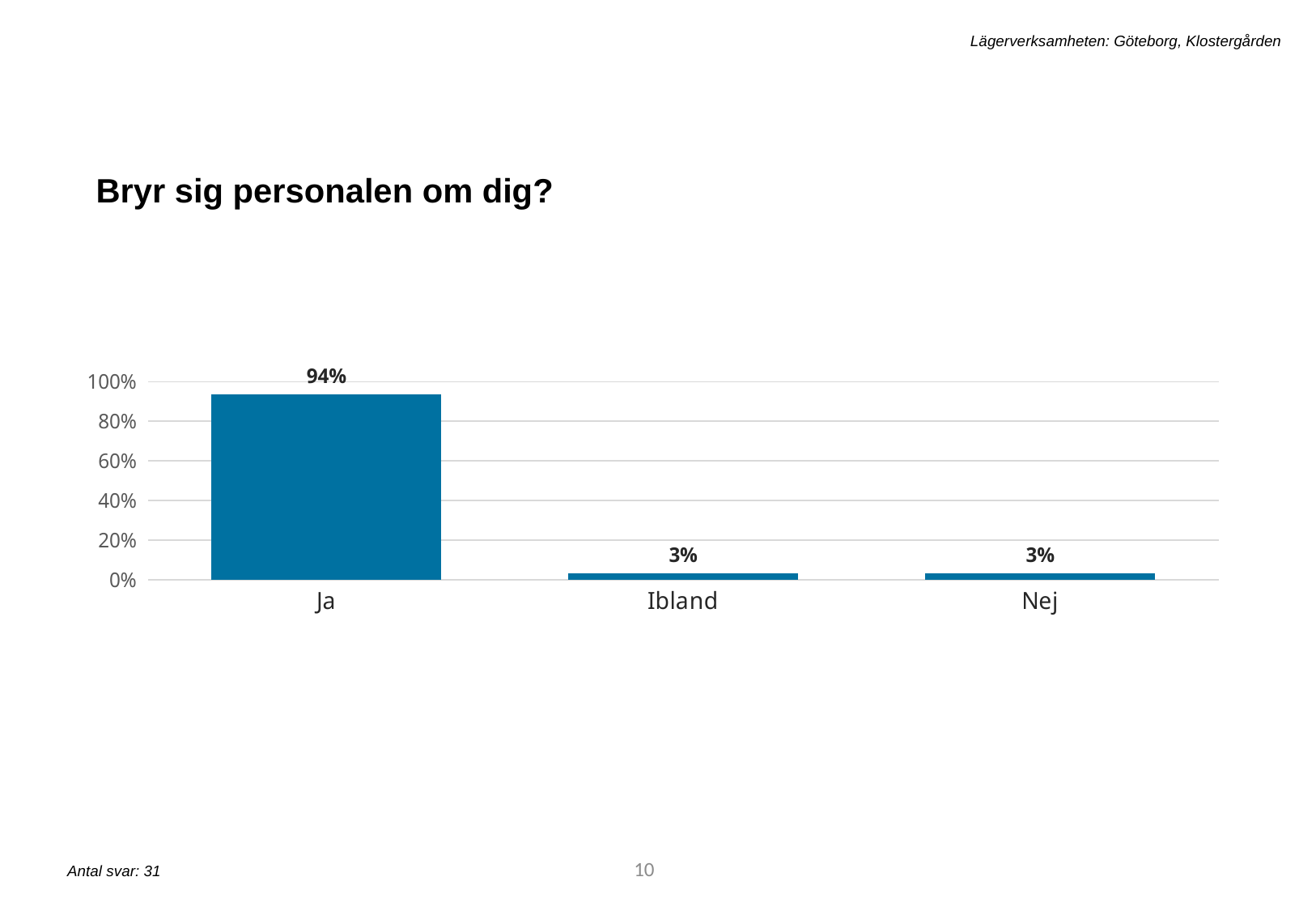
Is the value for Nej greater or less than 20%? less Which category has the highest value? Ja What is the title of the chart? Bryr sig personalen om dig? What is the difference between the values for Ja and Ibland? 91% What kind of chart is shown on the slide? bar chart What is the value for Ibland? 3% What is the value for Ja? 94% How many categories are shown on the x axis? 3 Which is larger, the value for Ja or the value for Ibland? Ja Is the value for Ja greater or less than 80%? greater What is the value for Nej? 3% What is the difference between the values for Ja and Nej? 91%